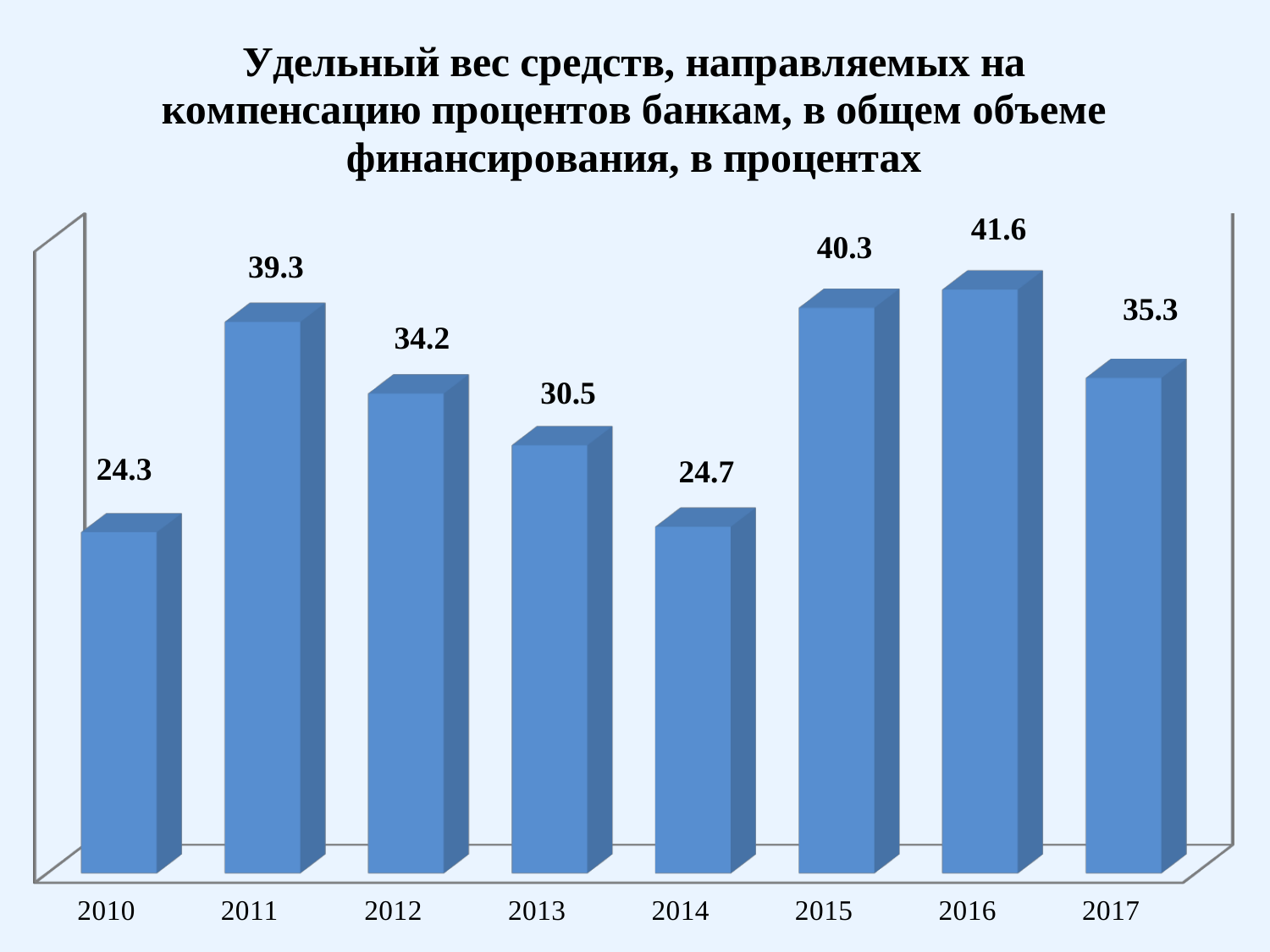
What is the difference between the values for 2011 and 2012? 5.1 What kind of chart is this? bar chart What colour are the bars? blue What is the value for 2015? 40.3 How many years are shown on the x axis? 8 What is the value for 2017? 35.3 What is the difference between the values for 2016 and 2010? 17.3 Do the values rise or fall from 2014 to 2016? rise Which year has the lowest value? 2010 Which year has the highest value? 2016 What is the value for 2010? 24.3 Which is larger, the value for 2013 or the value for 2014? 2013